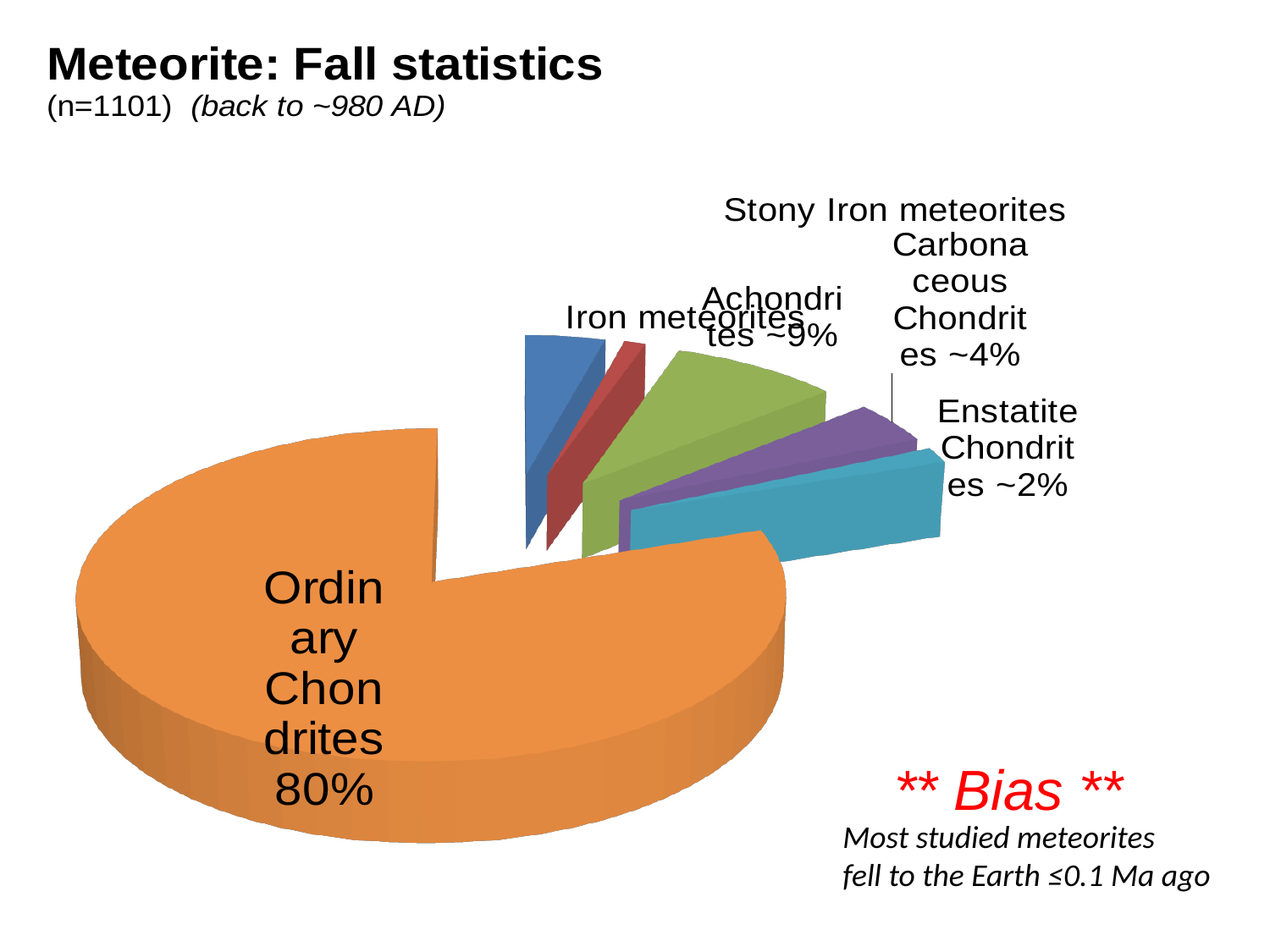
What percentage is shown for Achondrites? ~9% What share of the pie do Ordinary Chondrites account for? 80% What sample size (n) is stated for the fall statistics? n=1101 Which is larger, the slice for Ordinary Chondrites or the slice for Achondrites? Ordinary Chondrites Which category has the largest slice of the pie? Ordinary Chondrites What percentage is shown for Enstatite Chondrites? ~2% Which is larger, the slice for Achondrites or the slice for Enstatite Chondrites? Achondrites What percentage is shown for Carbonaceous Chondrites? ~4% What kind of chart is shown on the slide? pie chart How many slices does the pie chart have? 6 What is the title of the slide containing the pie chart? Meteorite: Fall statistics